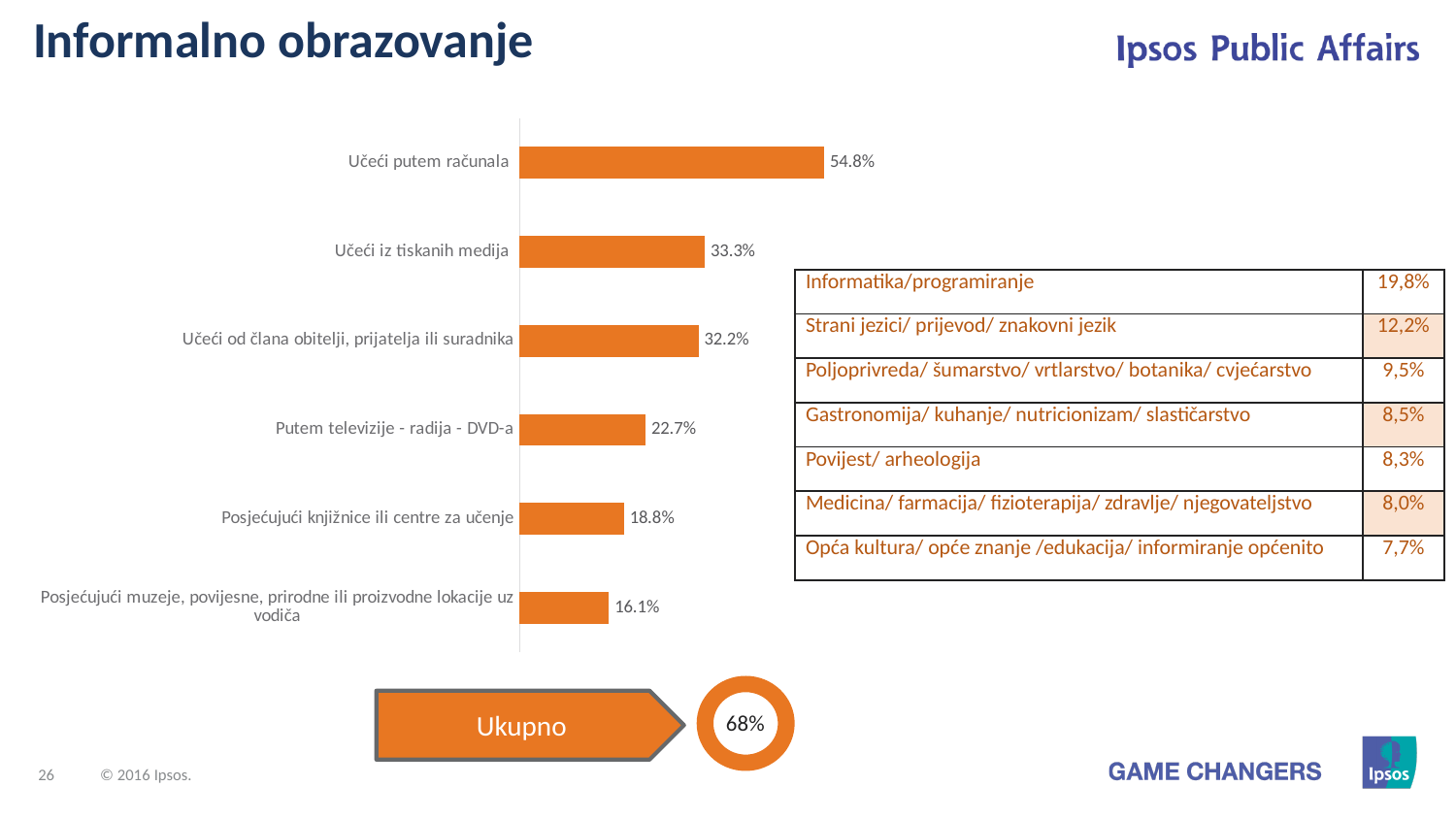
Which category has the highest value in the bar chart? Učeći putem računala What colour are the bars in the chart? Orange What is the value for "Posjećujući knjižnice ili centre za učenje" in the bar chart? 18.8% Which is larger in the bar chart: "Učeći iz tiskanih medija" or "Putem televizije - radija - DVD-a"? Učeći iz tiskanih medija What is the difference between the values for "Učeći putem računala" and "Učeći iz tiskanih medija" in the bar chart? 21.5% What is the value for "Učeći od člana obitelji, prijatelja ili suradnika" in the bar chart? 32.2% What kind of chart is shown on the slide? Bar chart What is the value for "Putem televizije - radija - DVD-a" in the bar chart? 22.7% How many categories are shown in the bar chart? 6 What is the difference between the values for "Posjećujući knjižnice ili centre za učenje" and "Posjećujući muzeje, povijesne, prirodne ili proizvodne lokacije uz vodiča"? 2.7% What is the value for "Učeći putem računala" in the bar chart? 54.8% Which category has the lowest value in the bar chart? Posjećujući muzeje, povijesne, prirodne ili proizvodne lokacije uz vodiča